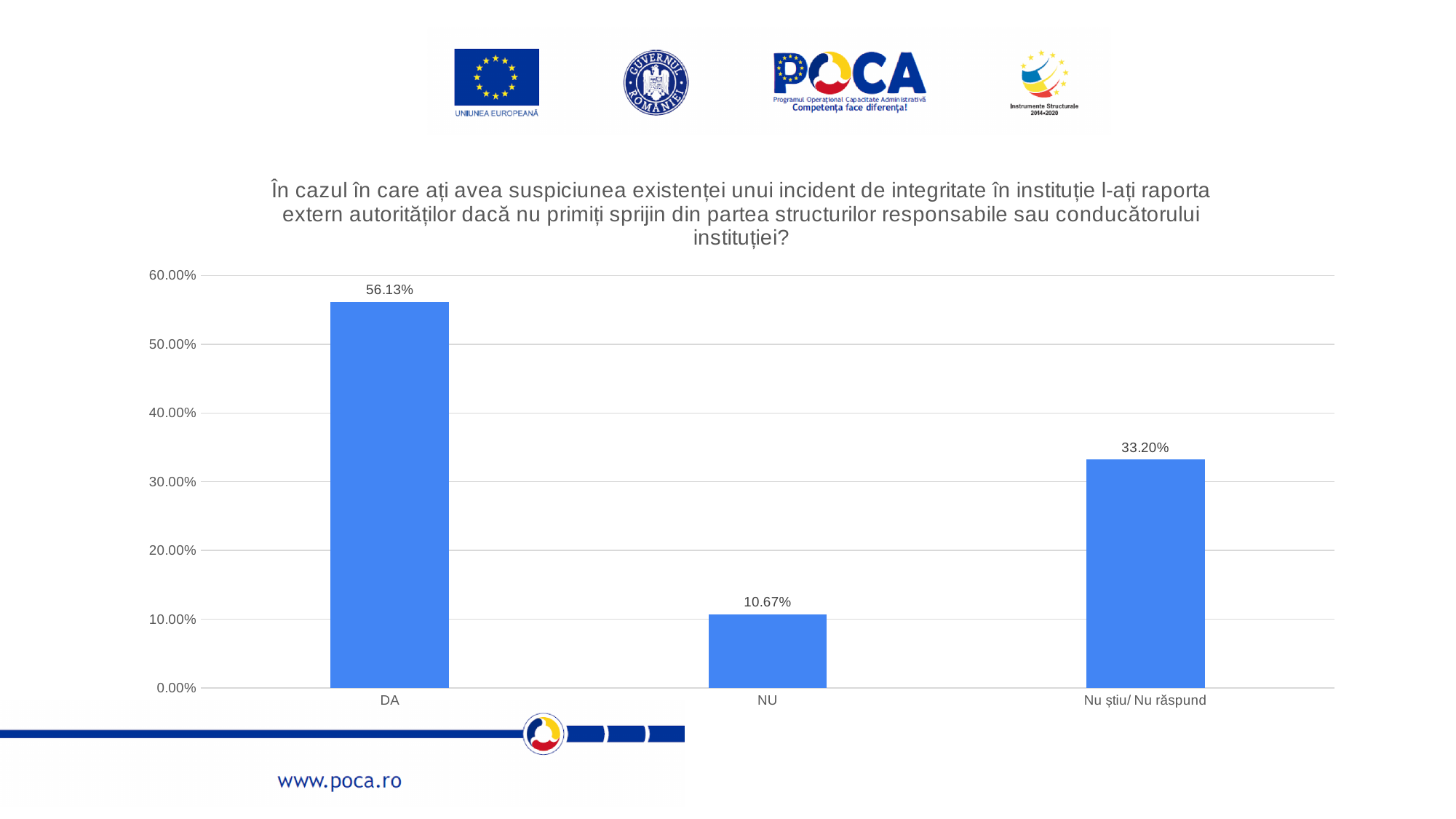
What kind of chart is shown on the slide? bar chart Which category has the highest value? DA How many categories are shown on the x axis? 3 What is the value for NU? 10.67% What is the highest value shown on the y axis? 60.00% What is the difference between the values for Nu știu/ Nu răspund and NU? 22.53% What is the value for DA? 56.13% What is the difference between the values for DA and NU? 45.46% Which is larger, the value for NU or the value for Nu știu/ Nu răspund? Nu știu/ Nu răspund What is the value for Nu știu/ Nu răspund? 33.20% Which category has the lowest value? NU Is the value for DA greater or less than 50.00%? greater